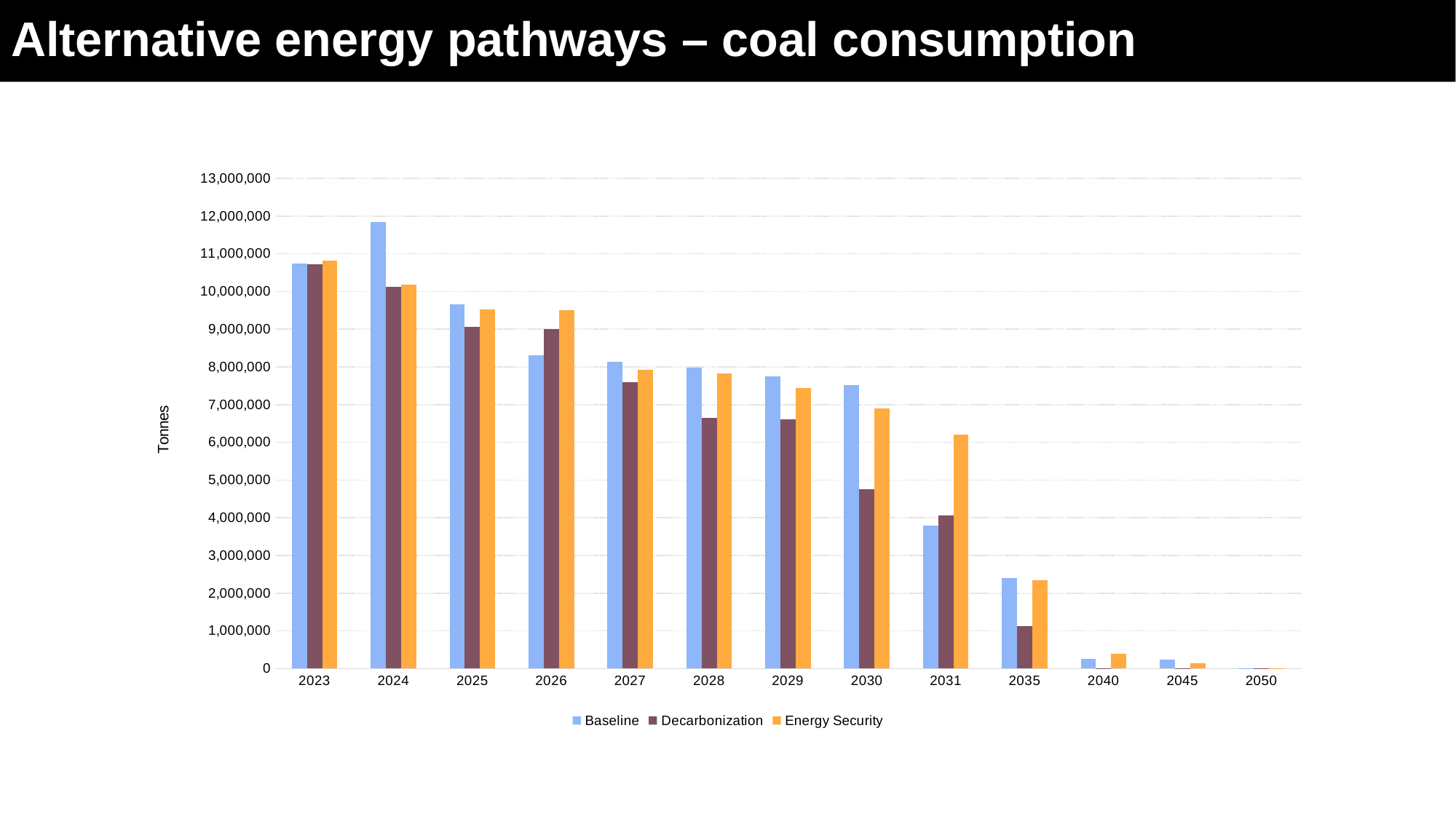
How many series does the legend list? 3 What kind of chart is shown on the slide? Bar chart Is the Baseline value for 2024 greater or less than 11,000,000? greater Is the Energy Security value for 2031 greater or less than 5,000,000? greater What is the label on the y axis? Tonnes Do the Baseline values rise or fall from 2024 to 2050? fall In 2030, which is larger: Baseline or Decarbonization? Baseline Is the Decarbonization value for 2030 greater or less than 5,000,000? less In 2031, which is larger: Baseline or Energy Security? Energy Security How many years are shown on the x axis? 13 In which year is the Baseline value highest? 2024 Which series has the lowest value in 2035? Decarbonization